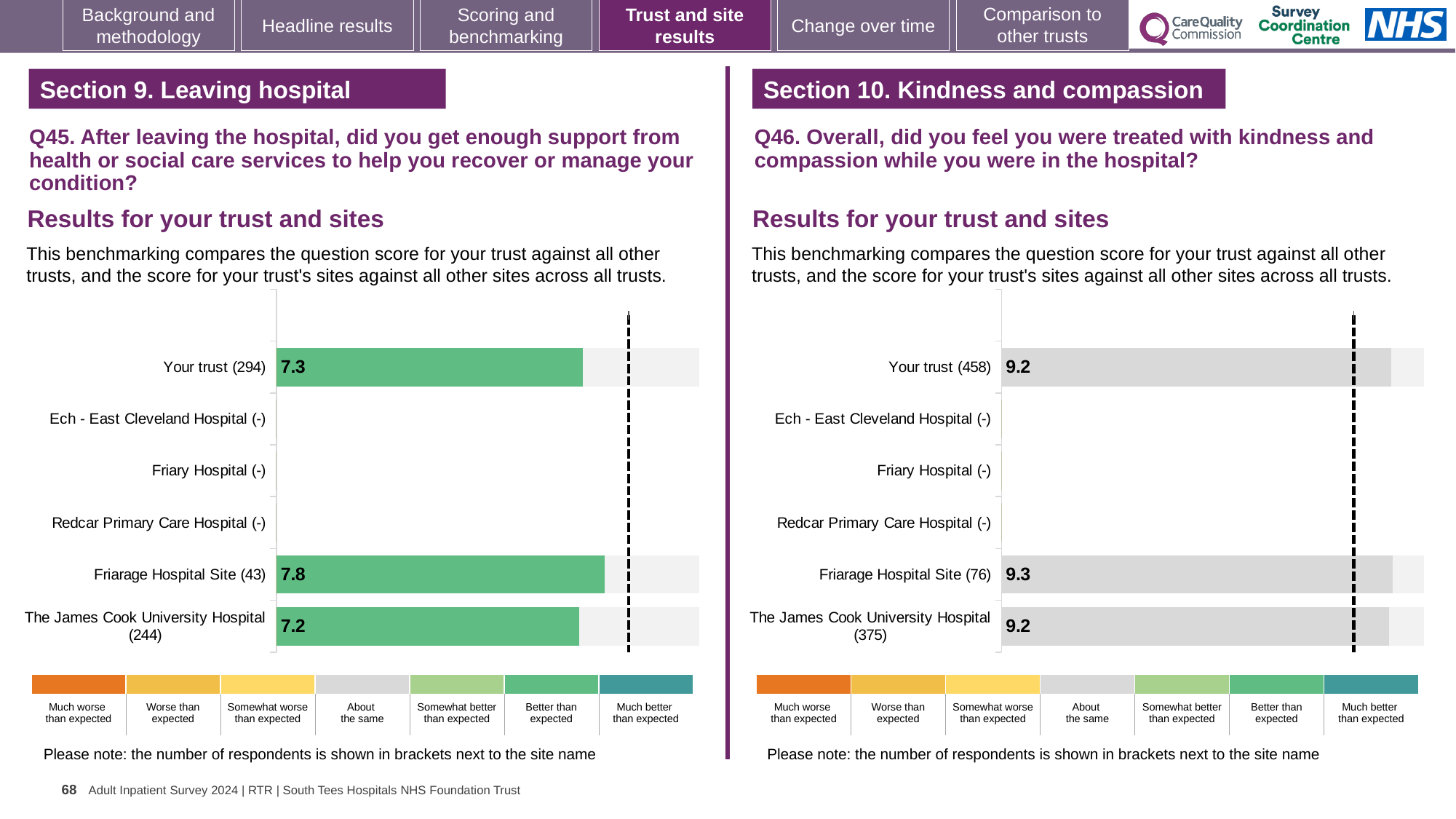
In the Q46 chart on the right, which is larger: the score for Friarage Hospital Site (76) or the score for Your trust (458)? Friarage Hospital Site (76) In the Q46 chart on the right, what is the score for The James Cook University Hospital (375)? 9.2 How many site or trust categories are listed on the y axis of the Q45 chart on the left? 6 In the Q45 chart on the left, what is the score for Friarage Hospital Site (43)? 7.8 In the Q45 chart on the left, what is the difference between the Friarage Hospital Site score and The James Cook University Hospital score? 0.6 What kind of chart is used for the Q46 results on the right? Bar chart In the Q46 chart on the right, which benchmark category does the colour of the bars correspond to according to the legend? About the same In the Q45 chart on the left, what is the score for Your trust (294)? 7.3 In the Q45 chart on the left, what is the score for The James Cook University Hospital (244)? 7.2 In the Q46 chart on the right, what is the score for Your trust (458)? 9.2 In the Q45 chart on the left, which site has the highest score? Friarage Hospital Site (43) In the Q46 chart on the right, what is the score for Friarage Hospital Site (76)? 9.3